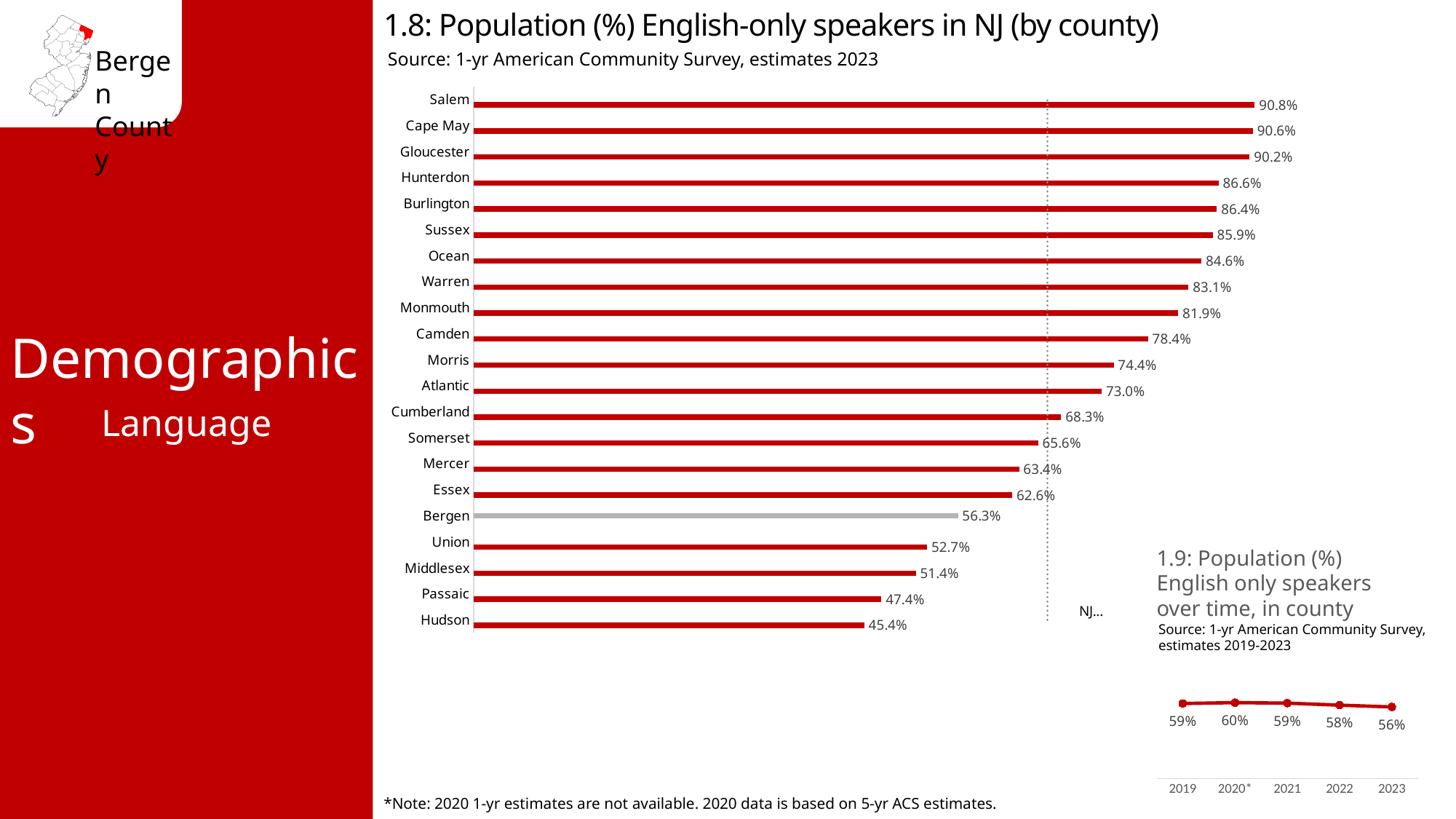
In chart 1.9, how many data points are plotted? 5 In chart 1.8, which county's bar is coloured grey instead of red? Bergen In chart 1.9, which year has the highest value? 2020* In chart 1.8, which has a larger value, Morris or Atlantic? Morris In chart 1.8, what is the value for Bergen? 56.3% In chart 1.8, which county has the lowest percentage of English-only speakers? Hudson In chart 1.8, which county has the highest percentage of English-only speakers? Salem In chart 1.8, how many counties are shown? 21 In chart 1.9, what is the value for 2023? 56% In chart 1.8, what is the difference between the values for Salem and Hudson? 45.4% What kind of chart is chart 1.8? Bar chart In chart 1.8, what is the value for Hudson? 45.4%